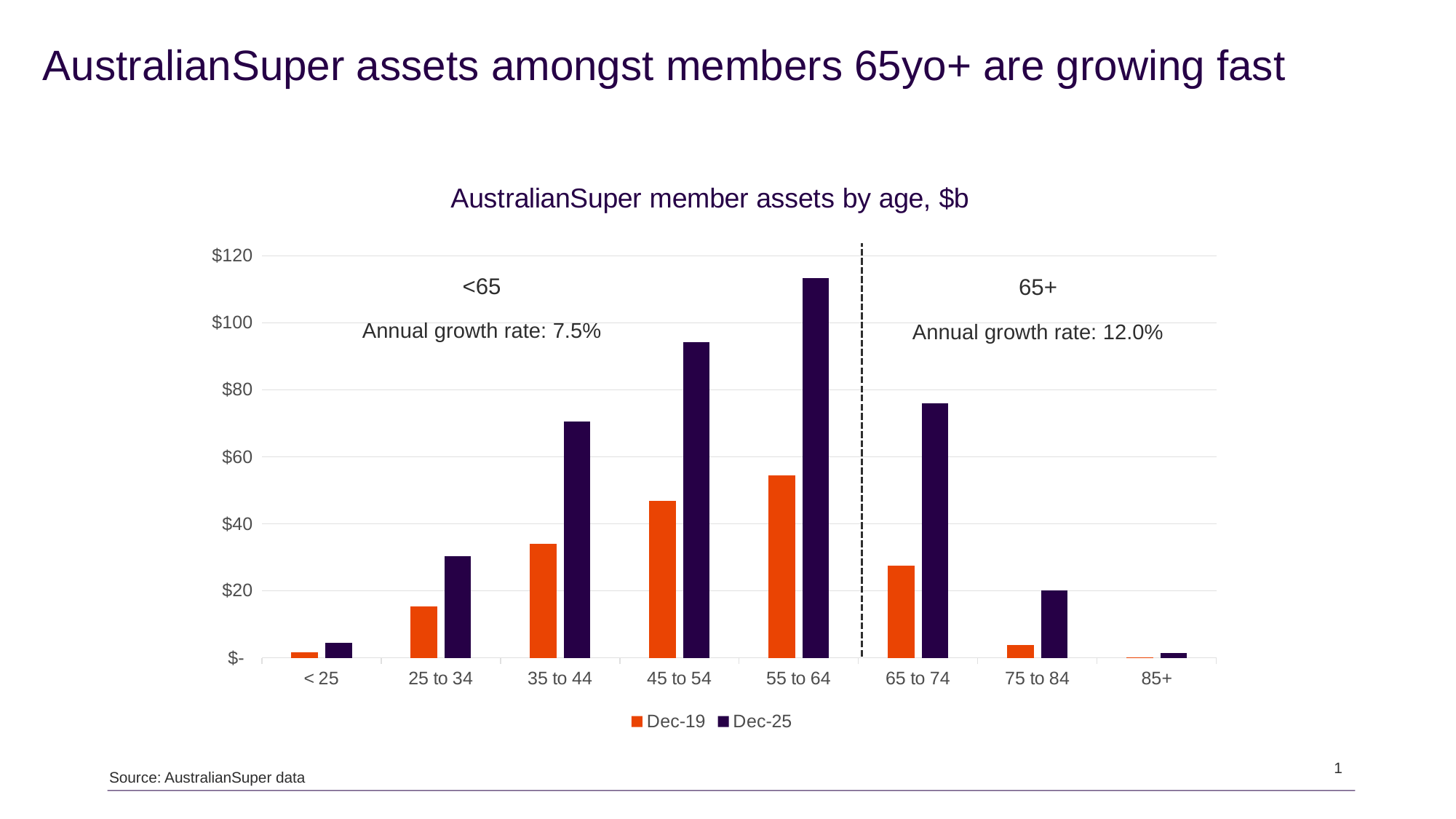
Which age category has the highest Dec-19 value? 55 to 64 Is the Dec-19 value for 25 to 34 greater or less than $20? less How many series does the legend list? 2 What annual growth rate is shown for the 65+ group? 12.0% Which age category has the highest Dec-25 value? 55 to 64 Which age category has the lowest Dec-25 value? 85+ Is the Dec-19 value for 65 to 74 greater or less than $40? less Is the Dec-25 value for 55 to 64 greater or less than $100? greater Which is larger: the Dec-19 value for 45 to 54 or the Dec-25 value for 25 to 34? Dec-19 value for 45 to 54 How many age categories are shown on the x axis? 8 What kind of chart is shown on the slide? bar chart